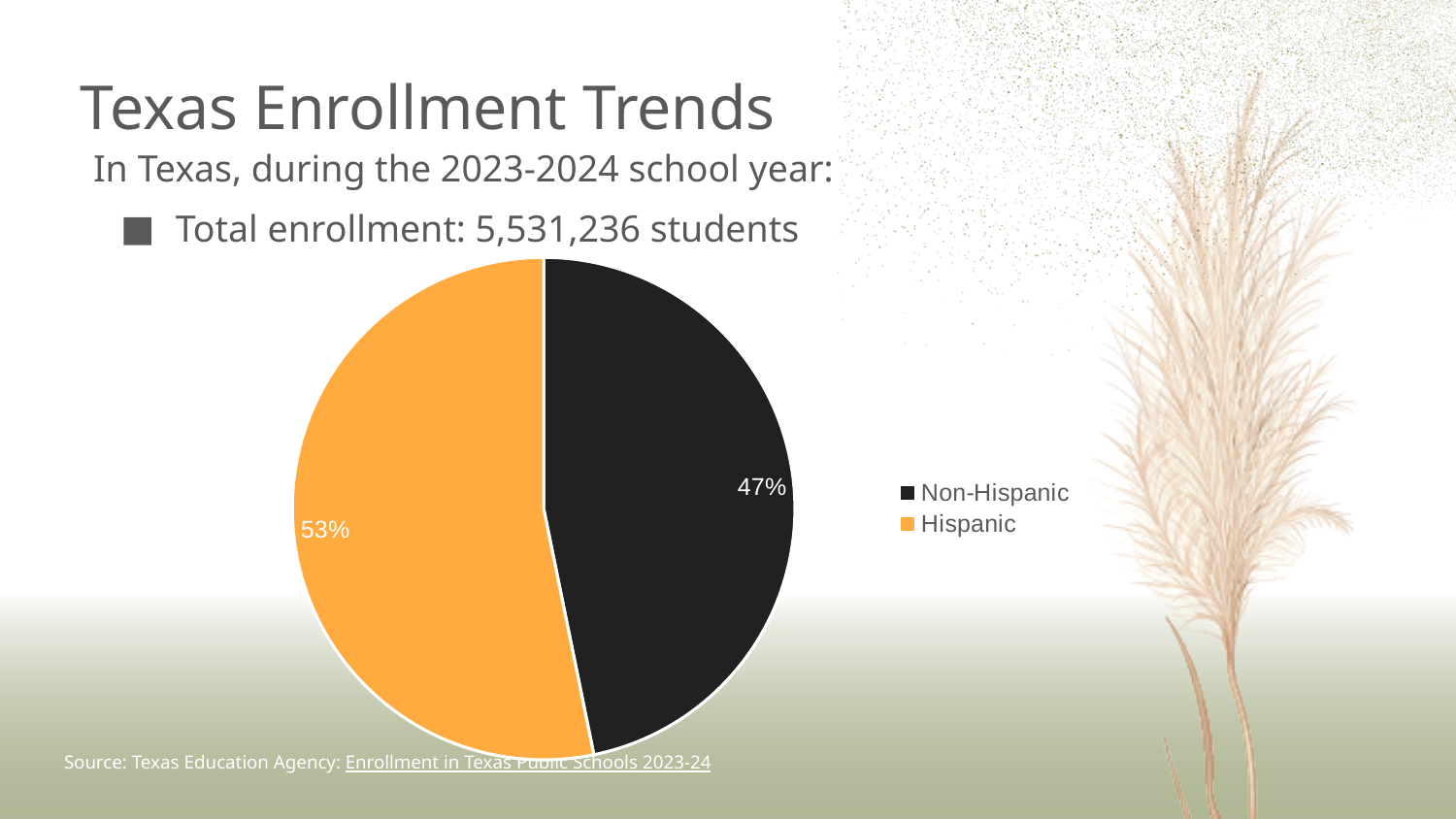
What colour is the Hispanic slice? orange Which slice of the pie is the largest? Hispanic What share of the pie is Hispanic? 53% What is the difference in percentage points between the Hispanic and Non-Hispanic slices? 6 What kind of chart is shown on the slide? pie chart Which is larger, the Hispanic slice or the Non-Hispanic slice? Hispanic What colour is the Non-Hispanic slice? black Which slice of the pie is the smallest? Non-Hispanic How many slices does the pie chart have? 2 Is the Hispanic share greater or less than 50%? greater What share of the pie is Non-Hispanic? 47% How many entries does the legend list? 2